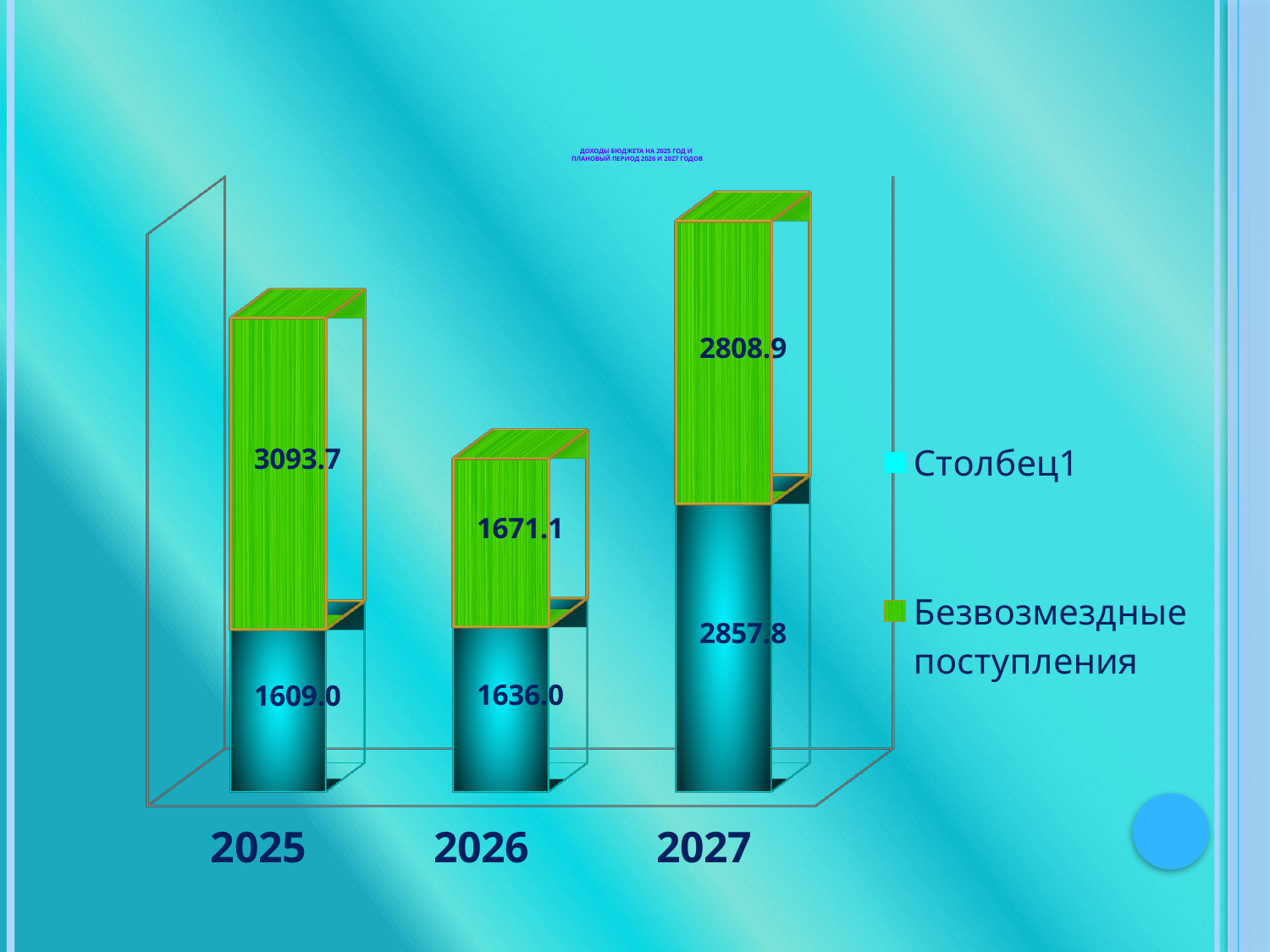
Which is larger for 2027: Столбец1 or Безвозмездные поступления? Столбец1 What is the total of the stacked bar for 2026? 3307.1 In which year is the value of Безвозмездные поступления the lowest? 2026 How many years (categories) are shown on the x axis? 3 What is the value of Безвозмездные поступления for 2027? 2808.9 In which year is the value of Столбец1 the highest? 2027 What is the value of Столбец1 for 2025? 1609.0 Does the value of Столбец1 rise or fall from 2025 to 2027? rise What is the value of Безвозмездные поступления for 2026? 1671.1 What type of chart is shown on the slide? stacked bar chart What is the difference between the Столбец1 values for 2027 and 2026? 1221.8 How many series does the legend list? 2